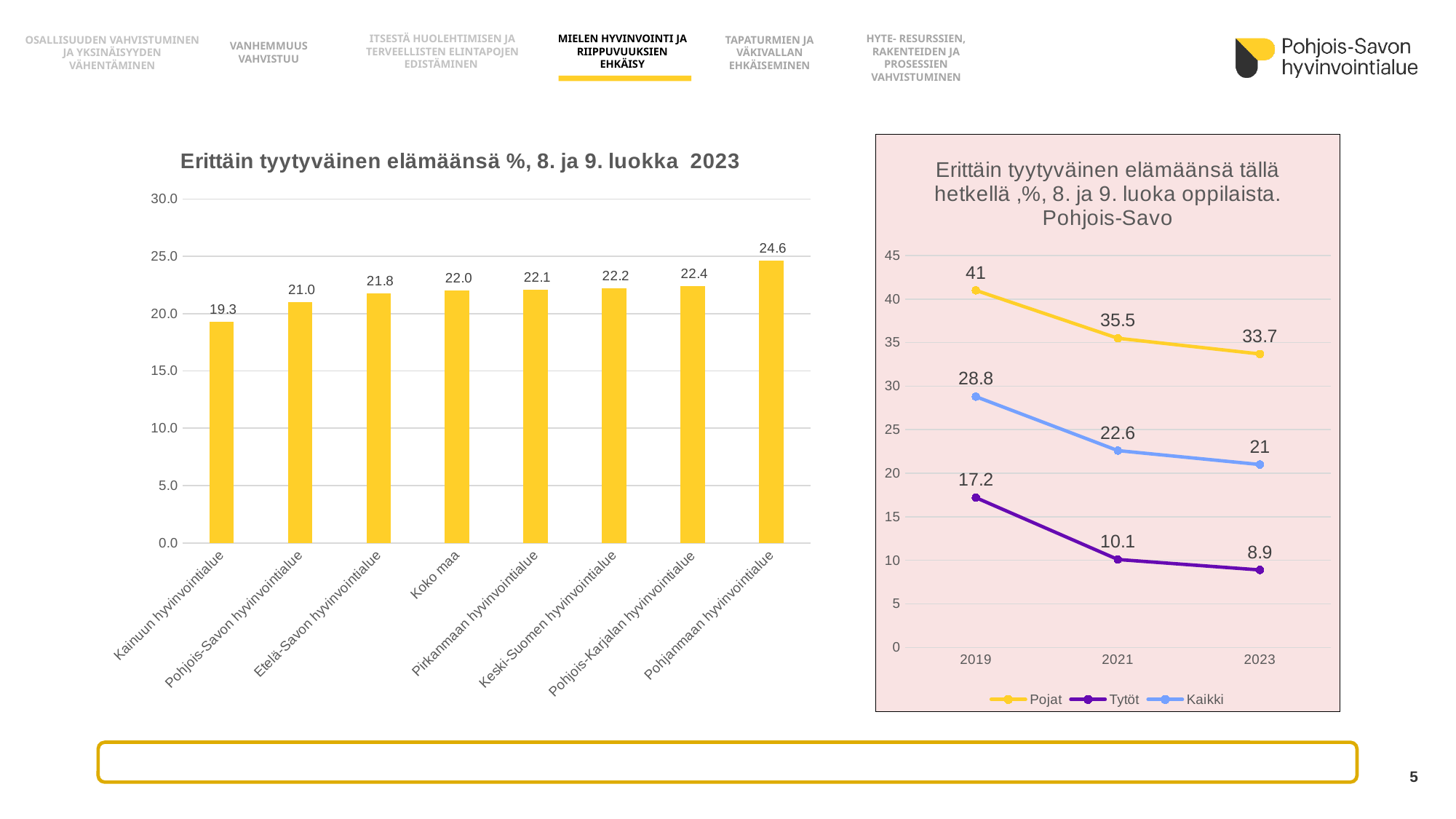
In the bar chart on the left, what is the value for Koko maa? 22.0 In the bar chart on the left, what is the value for Pohjois-Savon hyvinvointialue? 21.0 What kind of chart is the chart on the right? line chart In the line chart on the right, what is the value for Pojat in 2021? 35.5 In the bar chart on the left, which category has the highest value? Pohjanmaan hyvinvointialue In the line chart on the right, what is the value for Tytöt in 2023? 8.9 In the line chart on the right, how many series does the legend list? 3 In the bar chart on the left, which category has the lowest value? Kainuun hyvinvointialue In the line chart on the right, do the values for Kaikki rise or fall from 2019 to 2023? fall In the line chart on the right, what is the difference between Pojat and Tytöt in 2019? 23.8 In the bar chart on the left, how many categories are shown? 8 In the bar chart on the left, what is the difference between Pohjanmaan hyvinvointialue and Kainuun hyvinvointialue? 5.3